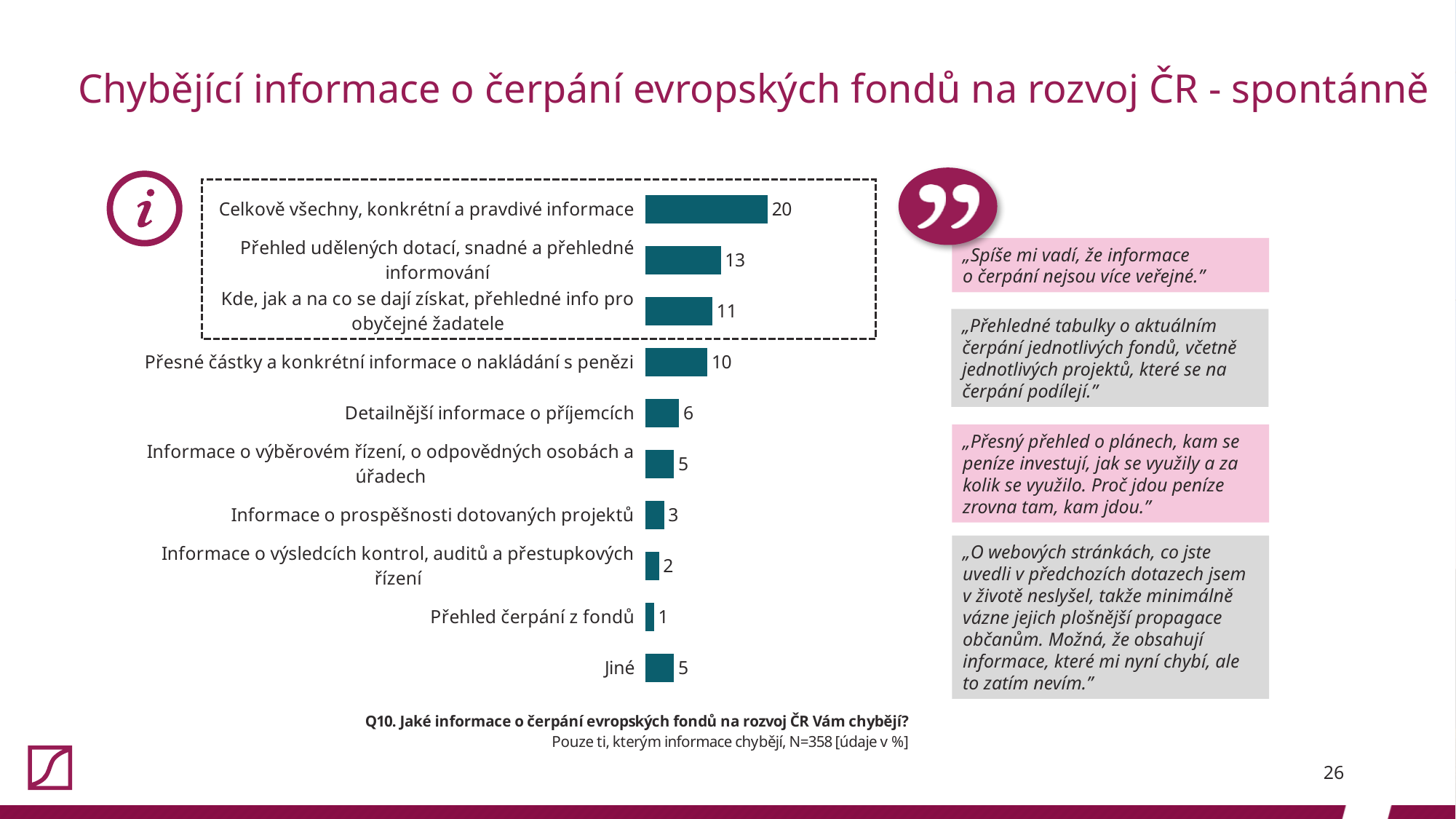
What is the value for "Informace o výsledcích kontrol, auditů a přestupkových řízení"? 2 Which is larger: the value for "Kde, jak a na co se dají získat, přehledné info pro obyčejné žadatele" or for "Přesné částky a konkrétní informace o nakládání s penězi"? Kde, jak a na co se dají získat, přehledné info pro obyčejné žadatele What is the value for "Celkově všechny, konkrétní a pravdivé informace"? 20 What is the value for "Přesné částky a konkrétní informace o nakládání s penězi"? 10 Which category has the lowest value? Přehled čerpání z fondů What is the difference between the values for "Celkově všechny, konkrétní a pravdivé informace" and "Přehled udělených dotací, snadné a přehledné informování"? 7 Which category has the highest value? Celkově všechny, konkrétní a pravdivé informace What is the value for "Detailnější informace o příjemcích"? 6 How many categories are shown in the chart? 10 What is the value for "Jiné"? 5 What kind of chart is shown on the slide? Bar chart What is the sample size (N) stated below the chart? N=358